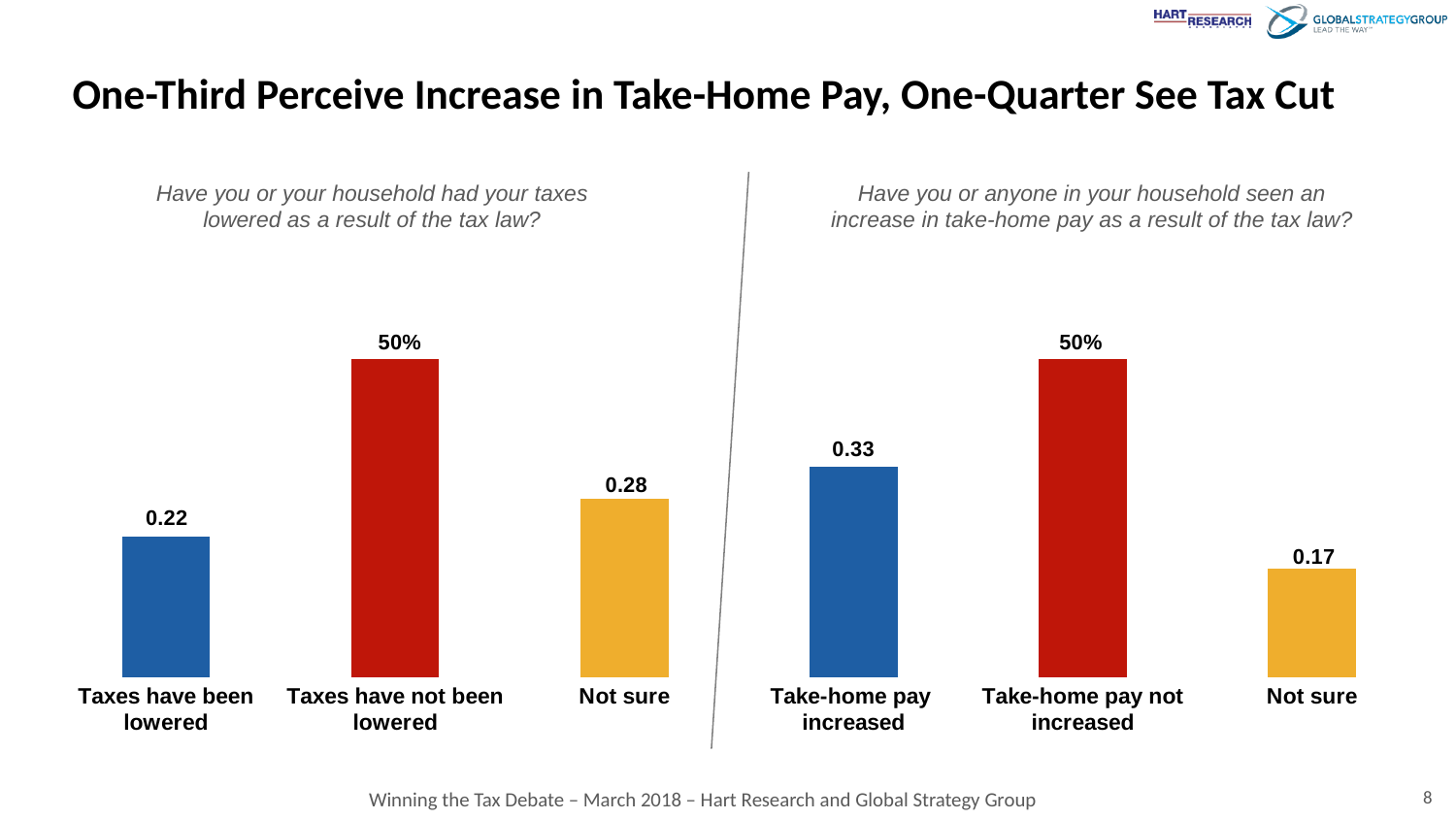
On the right chart, which category has the lowest value? Not sure On the left chart, what is the value for "Taxes have not been lowered"? 50% On the left chart, what is the difference between the values for "Not sure" and "Taxes have been lowered"? 0.06 On the left chart, which category has the highest value? Taxes have not been lowered How many categories does the right chart show? 3 On the left chart, what is the value for "Taxes have been lowered"? 0.22 On the right chart, what is the difference between the values for "Take-home pay increased" and "Not sure"? 0.16 On the right chart, which is larger: the value for "Take-home pay increased" or the value for "Not sure"? Take-home pay increased On the left chart, what is the value for "Not sure"? 0.28 On the right chart, what is the value for "Take-home pay increased"? 0.33 On the right chart, what is the value for "Not sure"? 0.17 What type of chart is used on the left side of the slide? Bar chart